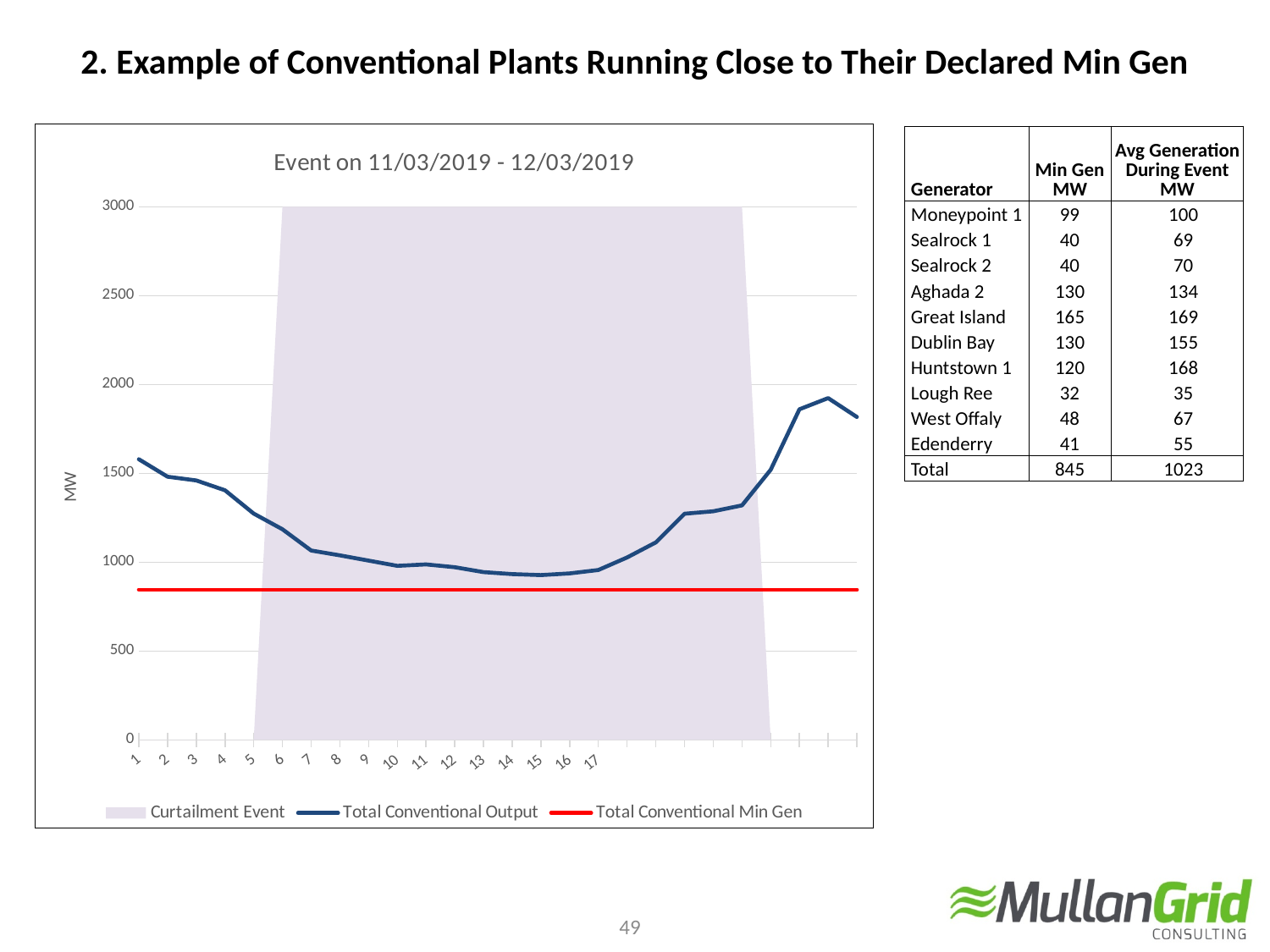
How many series does the chart legend list? 3 Is the value of Total Conventional Output at point 15 greater or less than 1000? less Does the Total Conventional Output line ever drop below the Total Conventional Min Gen line? No Is the Total Conventional Min Gen line greater or less than 500? greater What is the label on the vertical axis of the chart? MW Is Total Conventional Output higher at point 1 or at point 15? Point 1 Does Total Conventional Output rise or fall from point 1 to point 15? fall Is the Total Conventional Min Gen line greater or less than 1000? less What type of chart is shown on the slide? Combination area and line chart What is the title of the chart? Event on 11/03/2019 - 12/03/2019